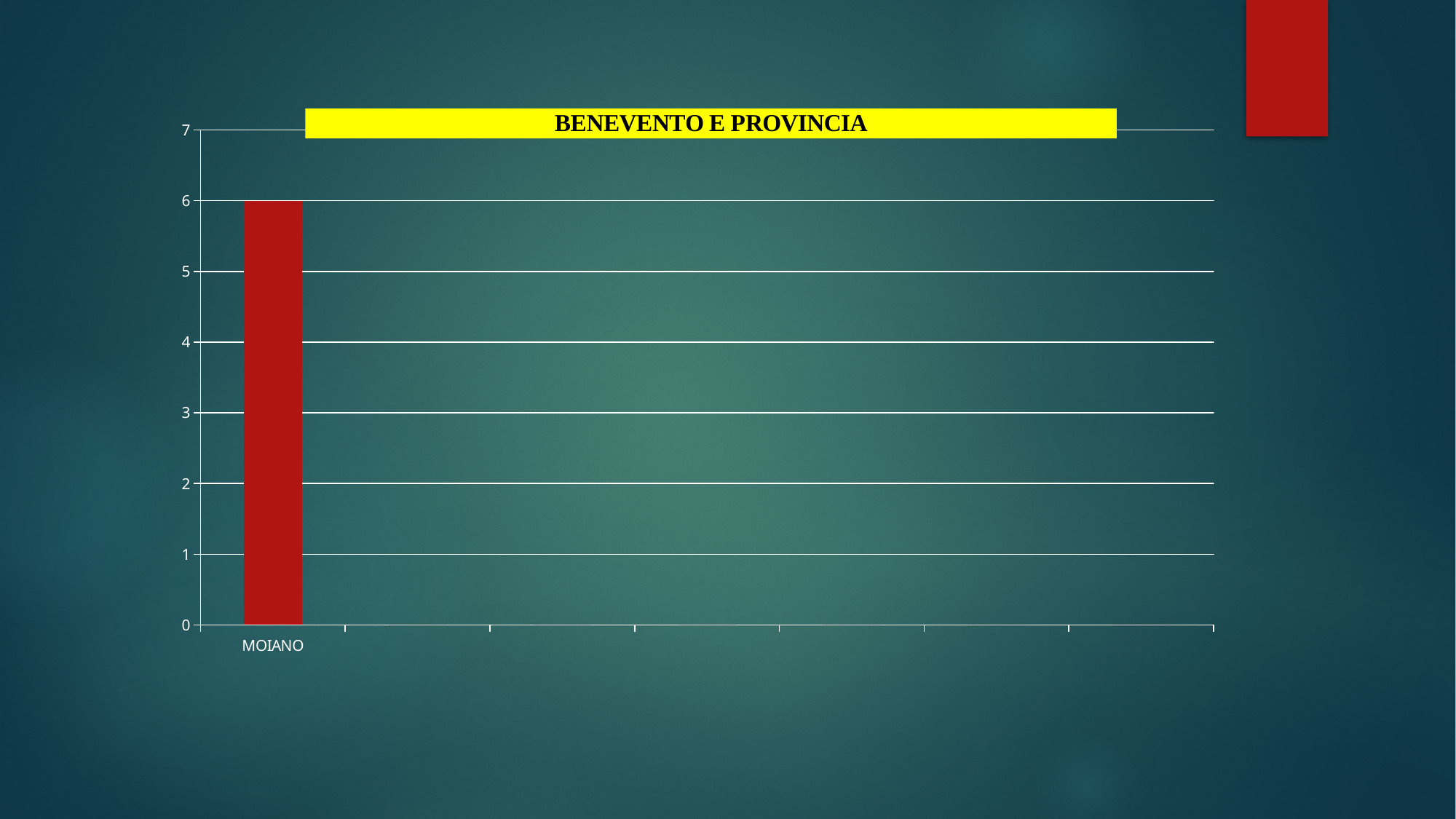
What colour is the bar for MOIANO? red What kind of chart is shown on the slide? bar chart What is the value for MOIANO? 6 How many bars are plotted on the chart? 1 Is the value for MOIANO greater or less than 7? less Which category has the highest value on the chart? MOIANO Is the value for MOIANO greater or less than 5? greater What is the title of the chart? BENEVENTO E PROVINCIA